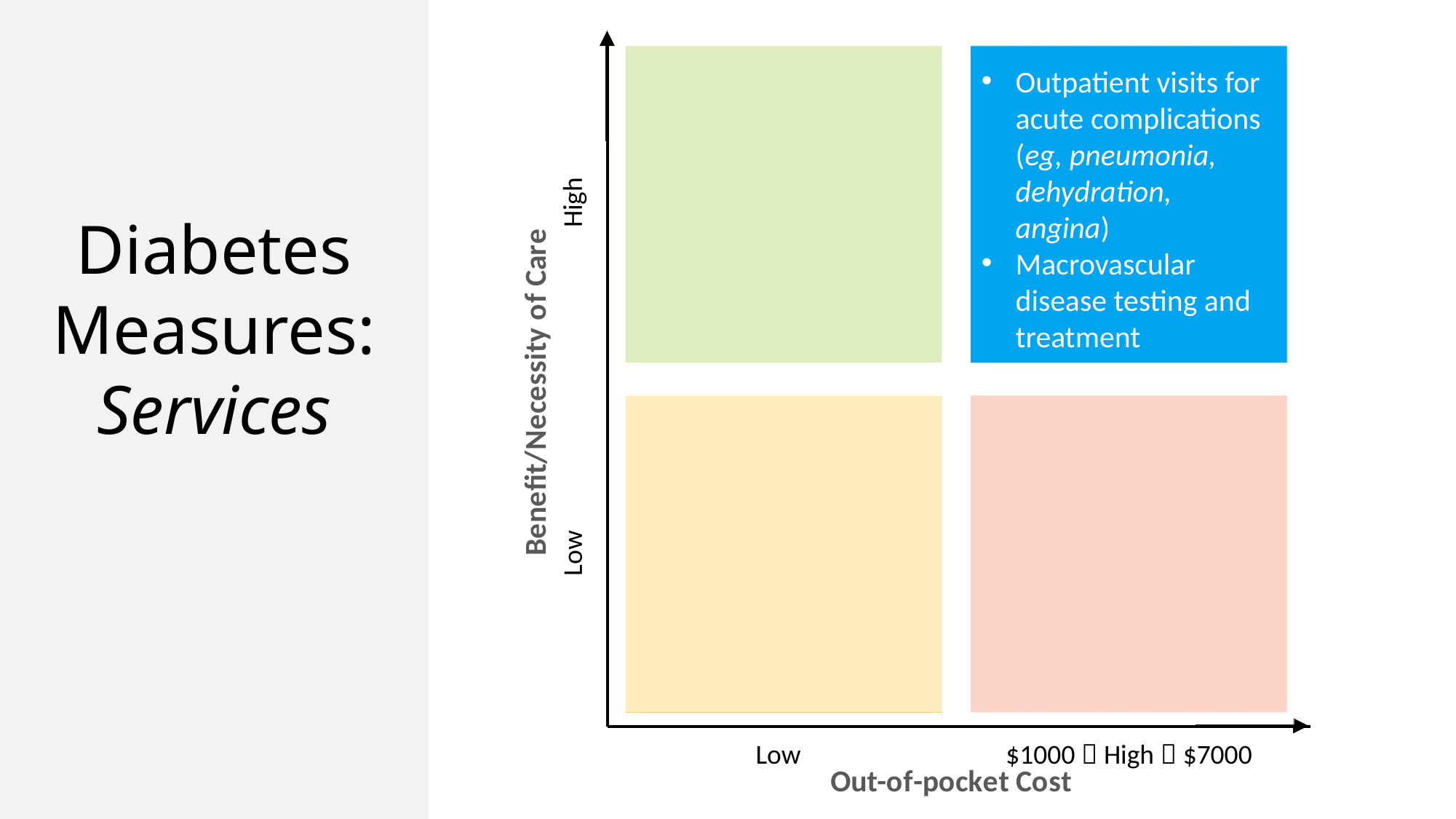
What is the label on the horizontal axis of the chart? Out-of-pocket Cost What is the label on the vertical axis of the chart? Benefit/Necessity of Care What cost range is shown for the 'High' out-of-pocket cost category on the horizontal axis? $1000 to $7000 How many quadrants does the chart contain? 4 In which quadrant does 'Macrovascular disease testing and treatment' appear? High benefit/necessity, high out-of-pocket cost How many services are listed in the blue (high benefit, high cost) quadrant? 2 Which quadrant of the chart contains text: the high-benefit/low-cost quadrant or the high-benefit/high-cost quadrant? High-benefit/high-cost